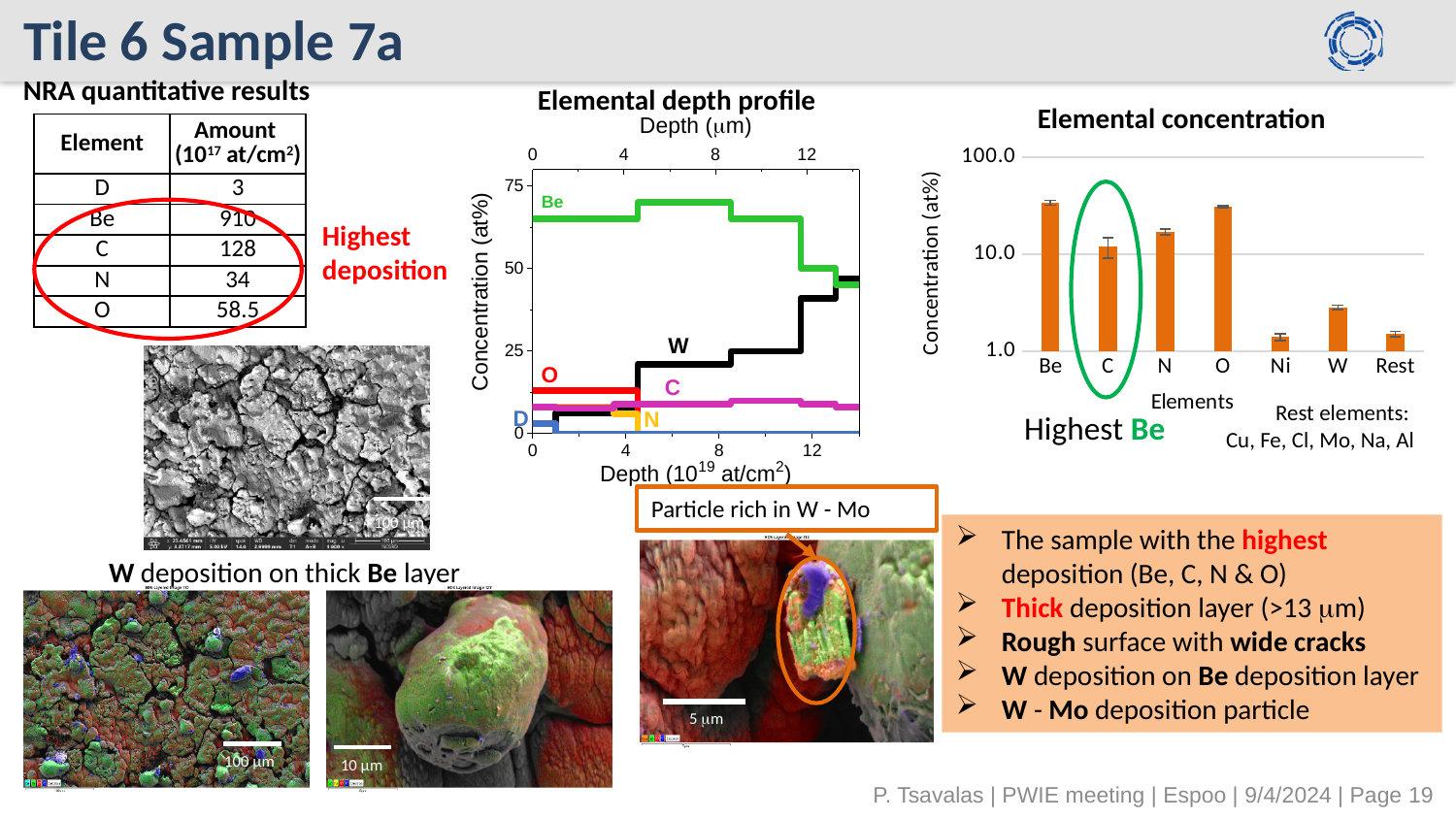
How many elements are shown on the x axis of the 'Elemental concentration' chart? 7 In the 'Elemental concentration' chart, which element has the highest concentration? Be What kind of chart is the 'Elemental concentration' chart? bar chart In the 'Elemental concentration' chart, is the value for Be greater or less than 10.0? greater In the 'Elemental depth profile' chart, does the W concentration rise or fall as depth increases? rise In the 'Elemental concentration' chart, which element is circled in green? C In the 'Elemental concentration' chart, which is larger, the value for W or the value for Ni? W In the 'Elemental concentration' chart, is the value for W greater or less than 10.0? less In the 'Elemental concentration' chart, which is larger, the value for O or the value for N? O In the 'Elemental concentration' chart, is the value for N greater or less than 10.0? greater How many element series are labelled in the 'Elemental depth profile' chart? 6